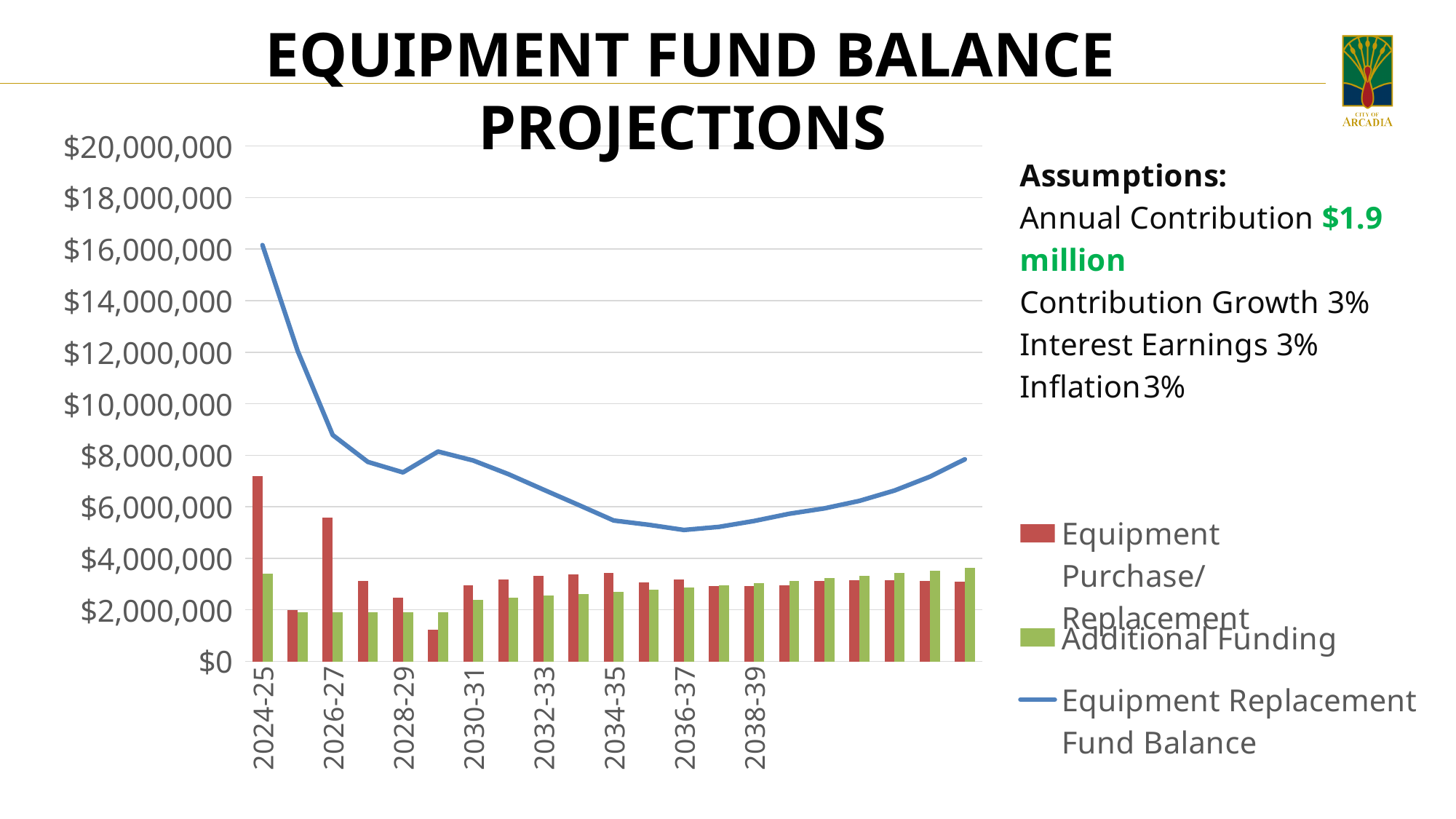
Is the Equipment Replacement Fund Balance for 2024-25 greater or less than $14,000,000? greater How many series does the legend list? 3 What colour represents Additional Funding in the chart? Green Do the Additional Funding bars generally rise or fall from 2026-27 onward? Rise In which year does the Equipment Replacement Fund Balance line reach its lowest point? 2036-37 What kind of chart is shown on the slide? A combination bar and line chart Is the Equipment Purchase/Replacement value for 2026-27 greater or less than $4,000,000? greater Is the Additional Funding value for 2024-25 greater or less than $4,000,000? less In 2024-25, which is larger: Equipment Purchase/Replacement or Additional Funding? Equipment Purchase/Replacement Does the Equipment Replacement Fund Balance rise or fall from 2024-25 to 2036-37? Fall In which year is the Equipment Purchase/Replacement bar highest? 2024-25